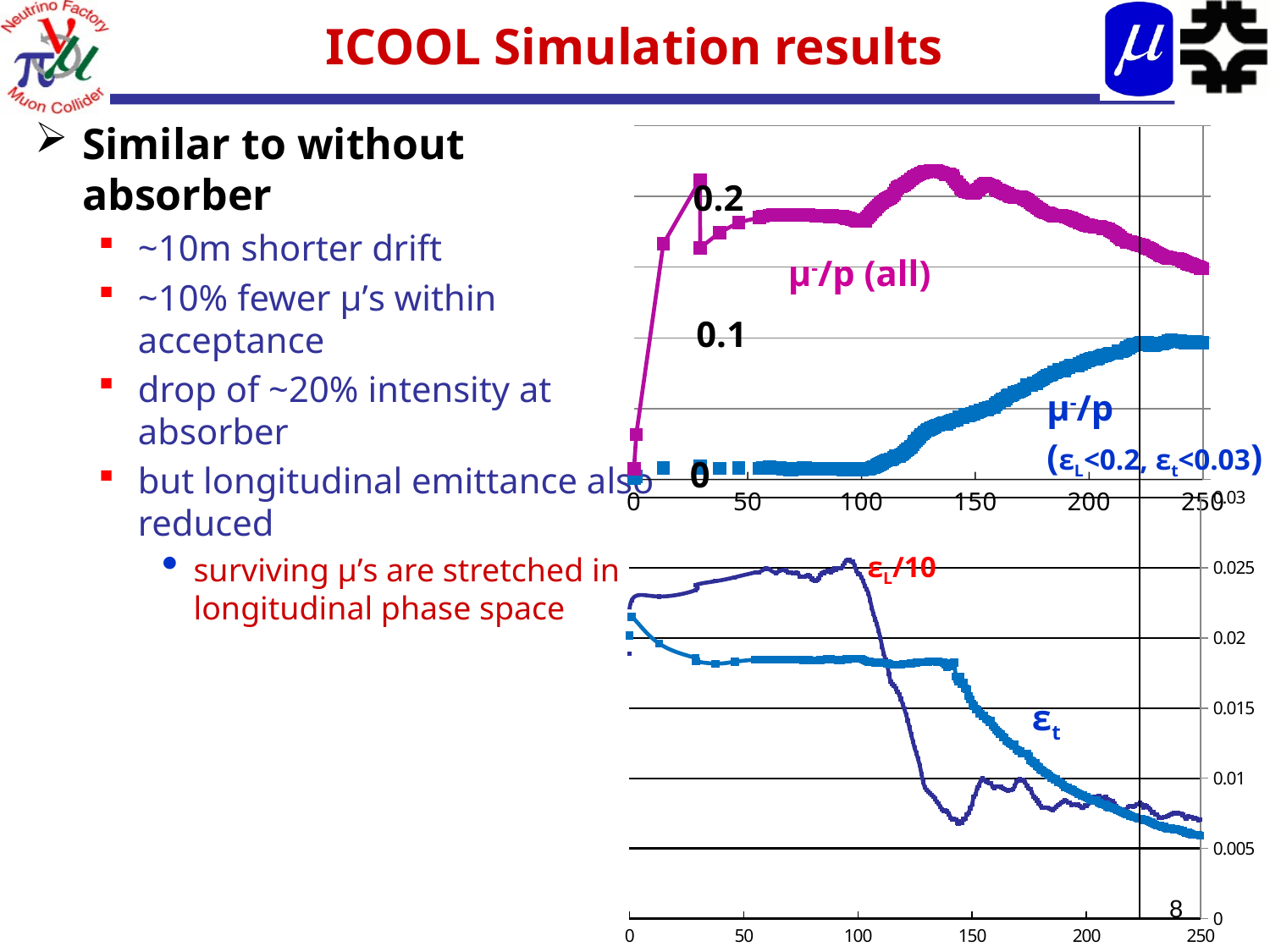
In the bottom chart, is the value of ε_L/10 at x = 50 greater or less than 0.02? greater What kind of chart is the top chart on the slide? line chart In the top chart, is the value of μ⁻/p (all) at x = 250 greater or less than 0.1? greater In the bottom chart, at x = 50, which series has the larger value: ε_L/10 or ε_t? ε_L/10 In the bottom chart, does the ε_t series rise or fall between x = 100 and x = 250? fall In the bottom chart, is the value of ε_t at x = 250 greater or less than 0.01? less What kind of chart is the bottom chart on the slide? line chart In the top chart, how many data series are plotted? 2 In the bottom chart, how many data series are plotted? 2 In the top chart, at x = 100, which series has the larger value: μ⁻/p (all) or μ⁻/p (ε_L<0.2, ε_t<0.03)? μ⁻/p (all) In the top chart, does the μ⁻/p (ε_L<0.2, ε_t<0.03) series rise or fall between x = 100 and x = 250? rise